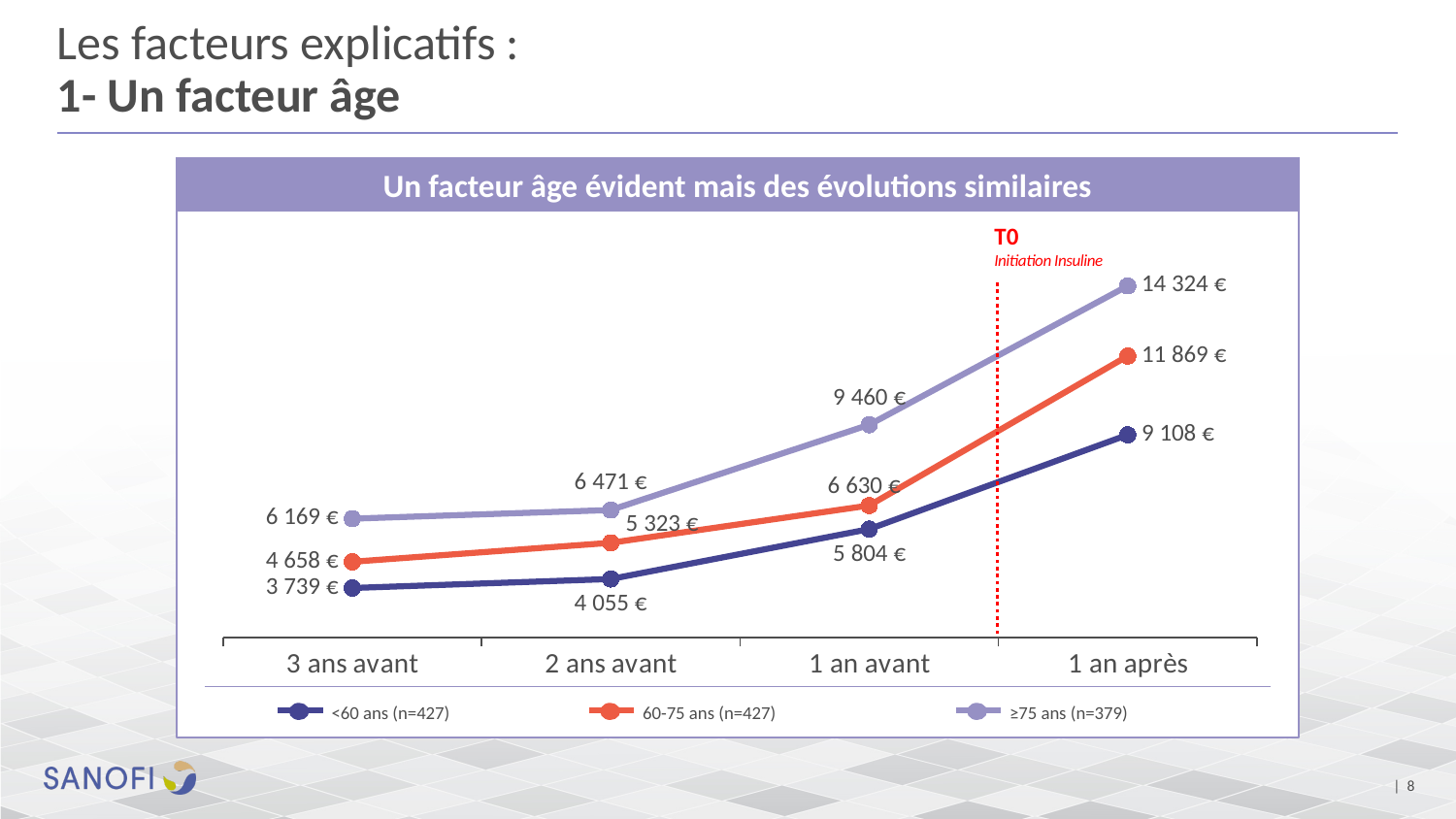
How many time points are shown on the x axis? 4 What is the value for the ≥75 ans (n=379) series at 1 an après? 14 324 € What is the value for the <60 ans (n=427) series at 2 ans avant? 4 055 € What is the value for the 60-75 ans (n=427) series at 1 an avant? 6 630 € Do the values for the 60-75 ans (n=427) series rise or fall from 3 ans avant to 1 an après? Rise Which is larger: the 60-75 ans (n=427) value at 1 an après or the ≥75 ans (n=379) value at 1 an avant? 60-75 ans (n=427) at 1 an après Which series has the lowest value at 3 ans avant? <60 ans (n=427) Which series has the highest value at 1 an après? ≥75 ans (n=379) How many series does the legend list? 3 What is the value for the <60 ans (n=427) series at 3 ans avant? 3 739 € What is the difference between the ≥75 ans (n=379) value and the <60 ans (n=427) value at 1 an après? 5 216 € What type of chart is shown on the slide? Line chart